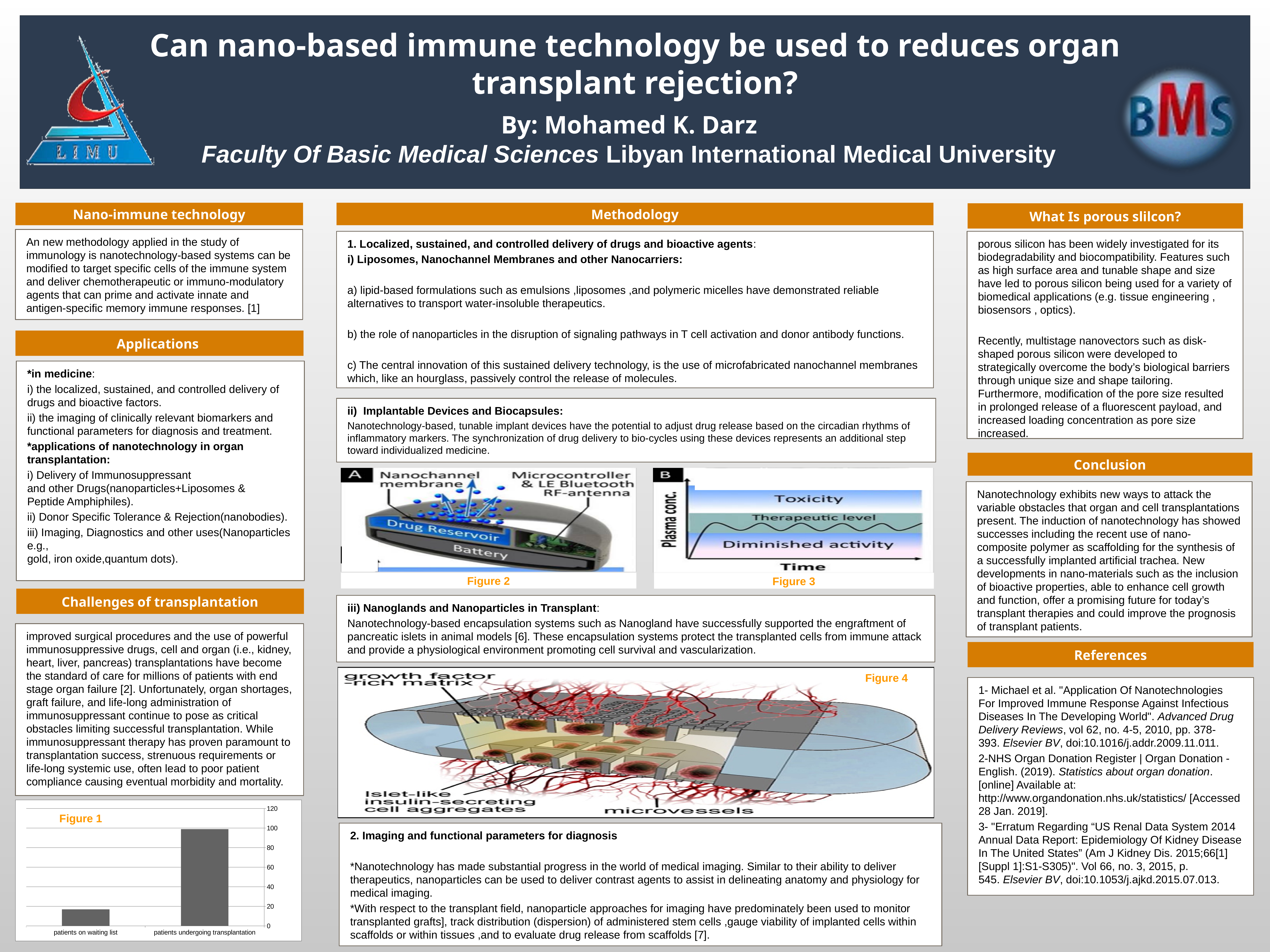
How many categories are shown in Figure 1? 2 What kind of chart is Figure 1? bar chart In Figure 1, is the value for patients undergoing transplantation greater or less than 60? greater In Figure 1, is the value for patients on waiting list greater or less than 40? less In Figure 1, which is larger: the value for patients on waiting list or the value for patients undergoing transplantation? patients undergoing transplantation In Figure 1, which category has the lowest value? patients on waiting list In Figure 1, which category has the highest value? patients undergoing transplantation What is the highest value shown on the vertical axis of Figure 1? 120 In Figure 1, is the value for patients undergoing transplantation greater or less than 80? greater What is the label of the chart in the bottom-left of the slide? Figure 1